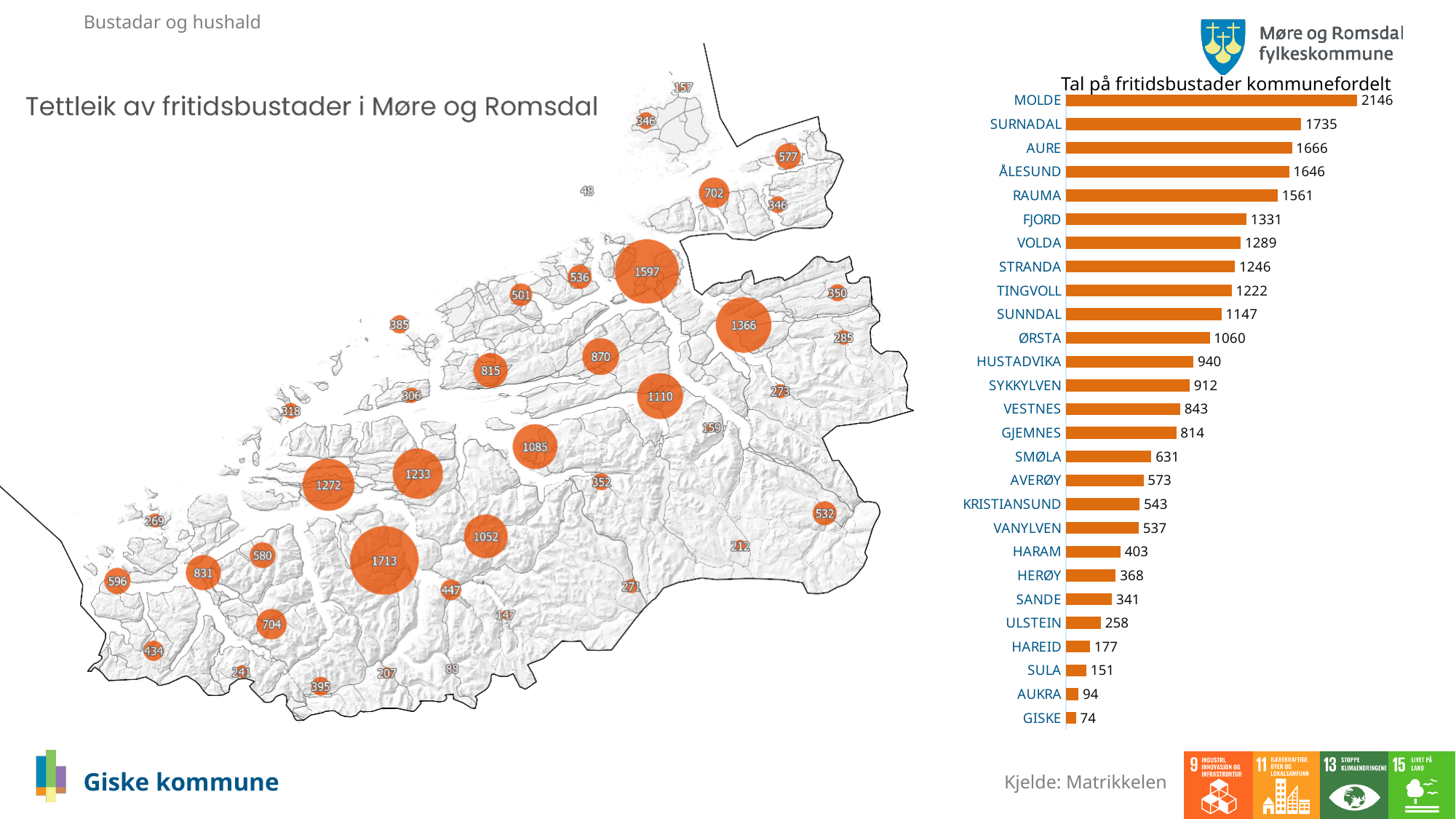
In the bar chart 'Tal på fritidsbustader kommunefordelt', what is the value for HUSTADVIKA? 940 What kind of chart is 'Tal på fritidsbustader kommunefordelt'? Bar chart In the bar chart 'Tal på fritidsbustader kommunefordelt', which has a larger value, VOLDA or STRANDA? VOLDA In the bar chart 'Tal på fritidsbustader kommunefordelt', which municipality has the highest value? MOLDE In the bar chart 'Tal på fritidsbustader kommunefordelt', which has a larger value, HARAM or SANDE? HARAM What is the title of the bar chart on the right side of the slide? Tal på fritidsbustader kommunefordelt In the bar chart 'Tal på fritidsbustader kommunefordelt', what is the value for GISKE? 74 In the bar chart 'Tal på fritidsbustader kommunefordelt', what is the difference between the values for SURNADAL and AURE? 69 How many municipalities are listed in the bar chart 'Tal på fritidsbustader kommunefordelt'? 27 In the bar chart 'Tal på fritidsbustader kommunefordelt', what is the value for MOLDE? 2146 In the bar chart 'Tal på fritidsbustader kommunefordelt', what is the difference between the values for MOLDE and GISKE? 2072 In the bar chart 'Tal på fritidsbustader kommunefordelt', which municipality has the lowest value? GISKE